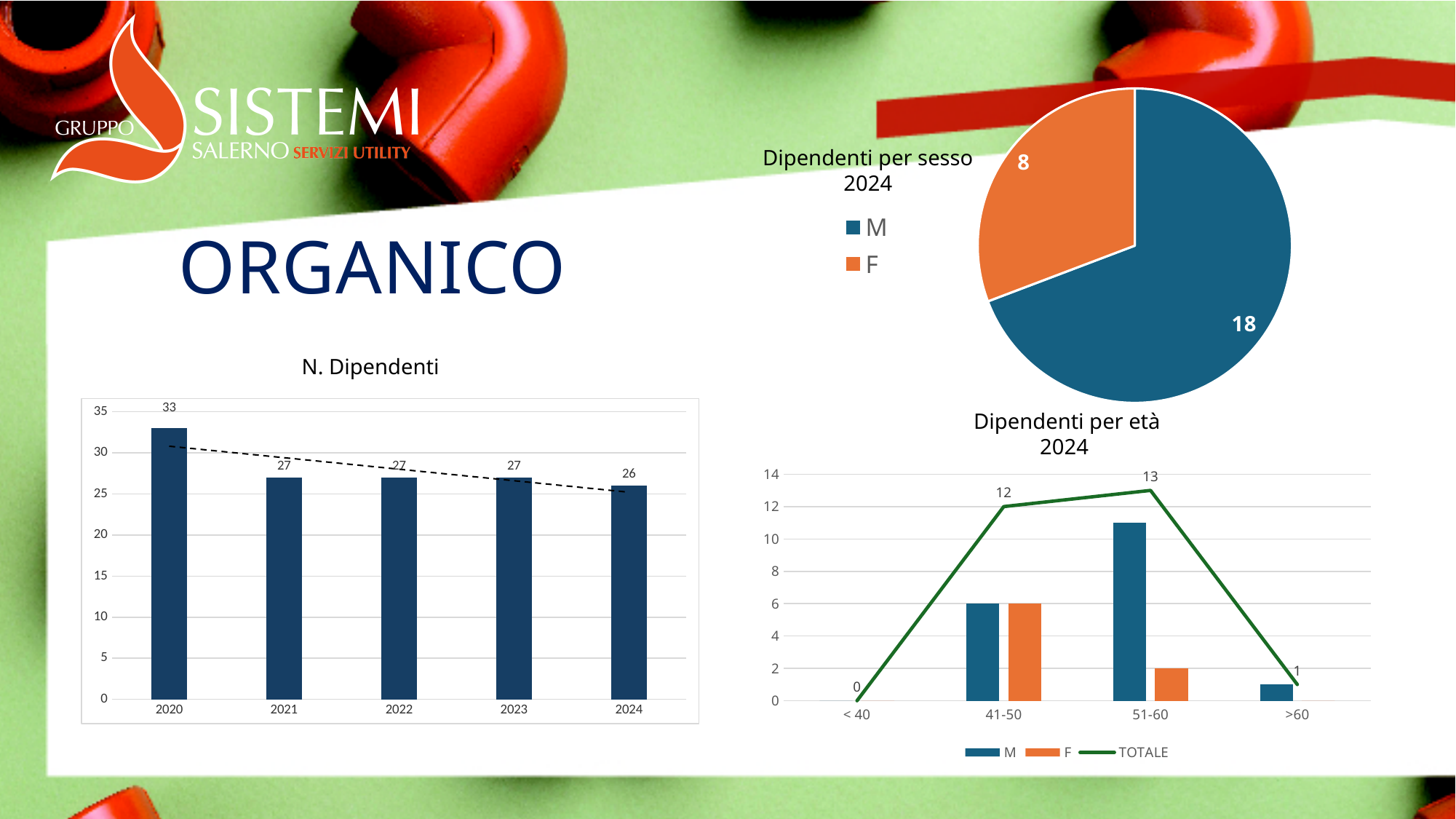
In the 'Dipendenti per età 2024' chart, is the M value for 51-60 greater or less than 10? greater In the 'Dipendenti per età 2024' chart, how many series does the legend list? 3 In the 'N. Dipendenti' chart, what is the value for 2024? 26 In the 'N. Dipendenti' chart, which year has the highest value? 2020 In the 'Dipendenti per età 2024' chart, what is the TOTALE value for 51-60? 13 In the 'N. Dipendenti' chart, what is the value for 2020? 33 In the 'Dipendenti per sesso 2024' chart, what is the value for M? 18 In the 'Dipendenti per sesso 2024' chart, what is the value for F? 8 In the 'N. Dipendenti' chart, what is the difference between the values for 2020 and 2024? 7 In the 'N. Dipendenti' chart, do the values generally rise or fall from 2020 to 2024? fall In the 'N. Dipendenti' chart, how many years are shown on the x axis? 5 What kind of chart is 'Dipendenti per sesso 2024'? pie chart